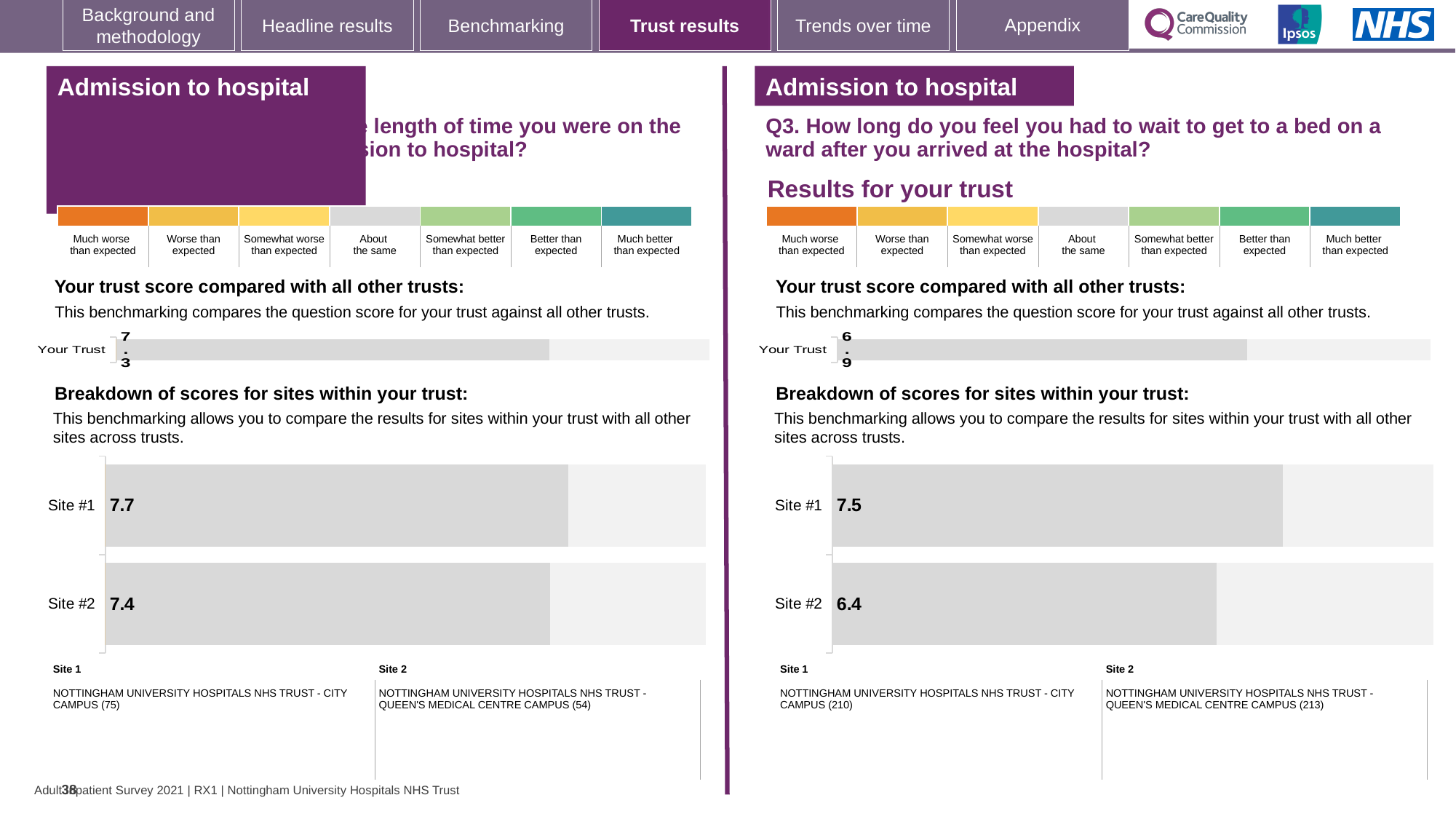
On the right panel (Q3) site breakdown chart, what is the difference between the Site #1 and Site #2 scores? 1.1 Which site has the lower score on the left panel's site breakdown chart? Site #2 What type of chart is used for the site breakdown on the right panel (Q3)? Bar chart On the left panel's site breakdown chart, what is the difference between the Site #1 and Site #2 scores? 0.3 On the right panel (Q3) site breakdown chart, what is the score for Site #2? 6.4 On the left panel's site breakdown chart, what is the score for Site #1? 7.7 On the left panel's site breakdown chart, how many sites are shown? 2 On the right panel (Q3) site breakdown chart, which site has the higher score? Site #1 On the left panel's site breakdown chart, what is the score for Site #2? 7.4 On the right panel (Q3) site breakdown chart, what is the score for Site #1? 7.5 On the left panel's 'Your trust score compared with all other trusts' chart, what is the score for Your Trust? 7.3 On the right panel (Q3) 'Your trust score compared with all other trusts' chart, what is the score for Your Trust? 6.9